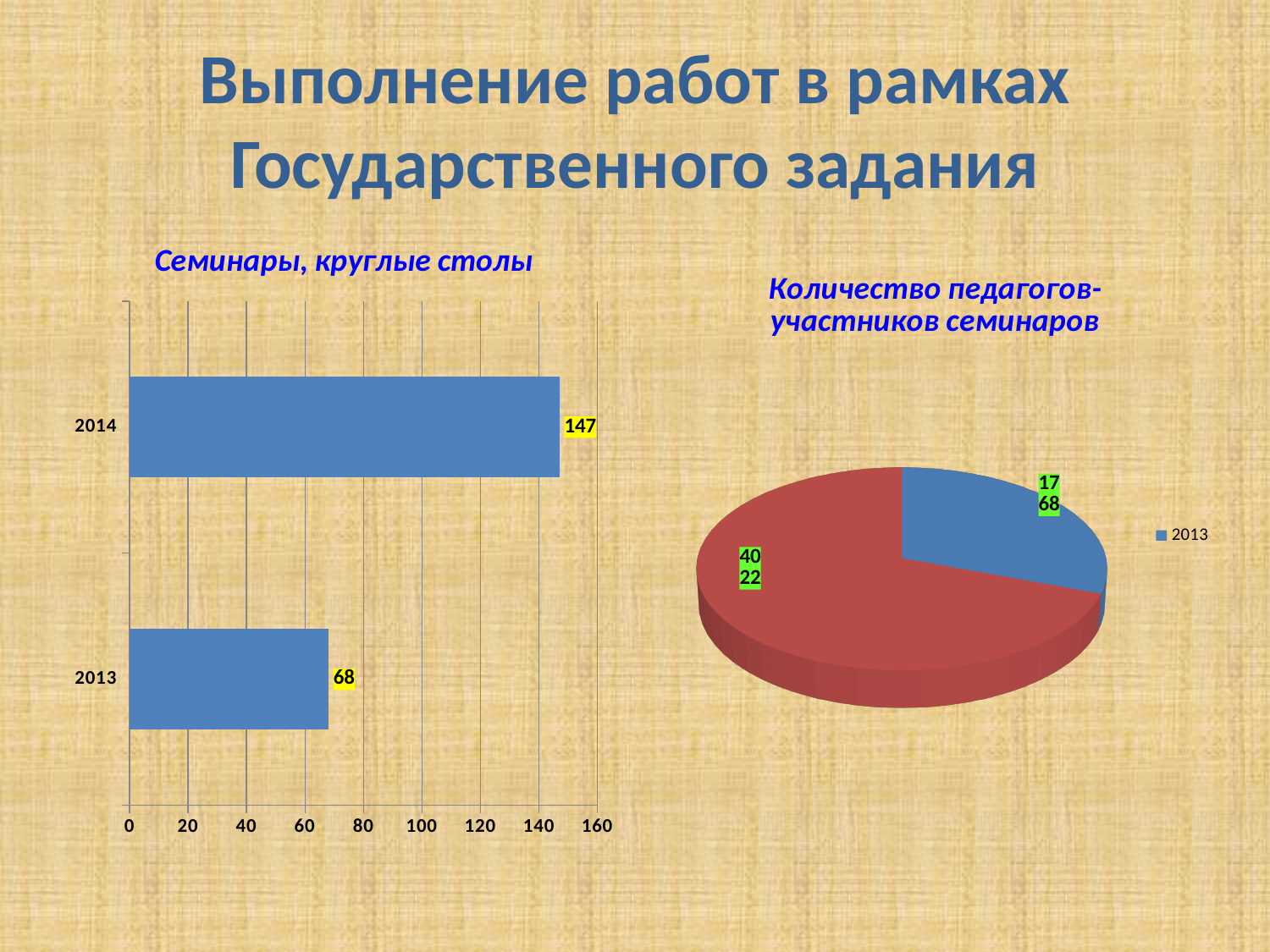
On the pie chart titled "Количество педагогов-участников семинаров", how many slices are there? 2 What kind of chart is the chart titled "Количество педагогов-участников семинаров"? pie chart What kind of chart is the chart on the left of the slide? bar chart On the bar chart titled "Семинары, круглые столы", what is the value for 2013? 68 On the bar chart titled "Семинары, круглые столы", which year has the lower value? 2013 On the pie chart titled "Количество педагогов-участников семинаров", what entry does the legend show? 2013 On the bar chart titled "Семинары, круглые столы", which year has the higher value? 2014 On the bar chart titled "Семинары, круглые столы", how many categories are shown? 2 On the pie chart titled "Количество педагогов-участников семинаров", which slice is larger, the red one or the blue one? the red one On the bar chart titled "Семинары, круглые столы", is the value for 2014 greater or less than 140? greater On the bar chart titled "Семинары, круглые столы", what is the difference between the values for 2014 and 2013? 79 On the bar chart titled "Семинары, круглые столы", what is the value for 2014? 147